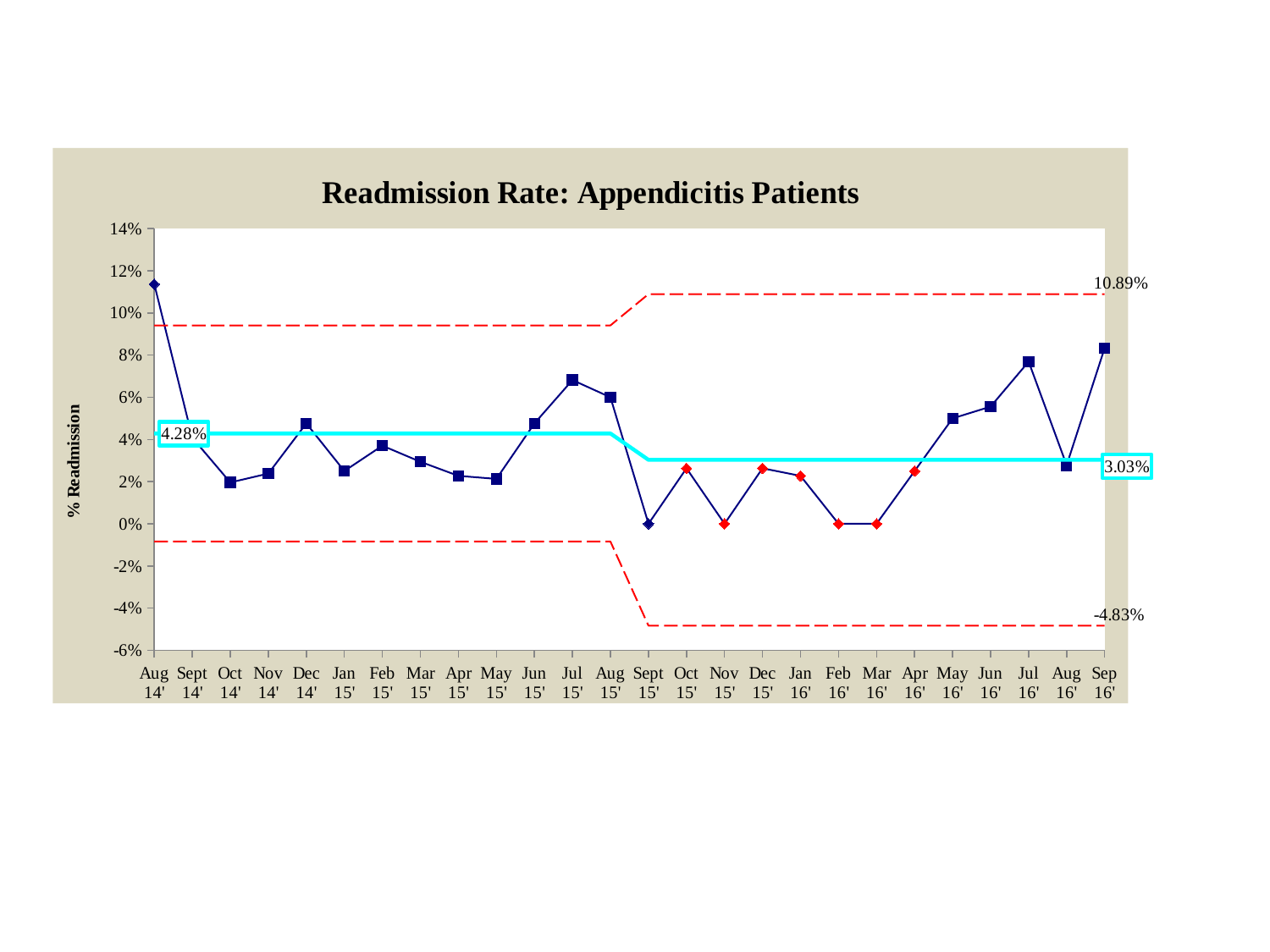
Which month has the highest readmission rate on the chart? Aug 14' What value is labelled on the upper dashed limit line at the right of the chart? 10.89% What value is labelled on the lower dashed limit line at the right of the chart? -4.83% What is the title of the chart? Readmission Rate: Appendicitis Patients What value is labelled on the centre line for the first period (Aug 14' to Aug 15')? 4.28% What is the label on the vertical axis of the chart? % Readmission How many monthly data points are plotted on the chart? 26 What kind of chart is shown on the slide? line chart What value is labelled on the centre line for the second period (Sept 15' to Sep 16')? 3.03% What is the difference between the two labelled centre-line values, 4.28% and 3.03%? 1.25% Which is larger, the readmission rate for Jul 16' or for Aug 16'? Jul 16' Is the readmission rate for Aug 14' greater or less than 10%? greater